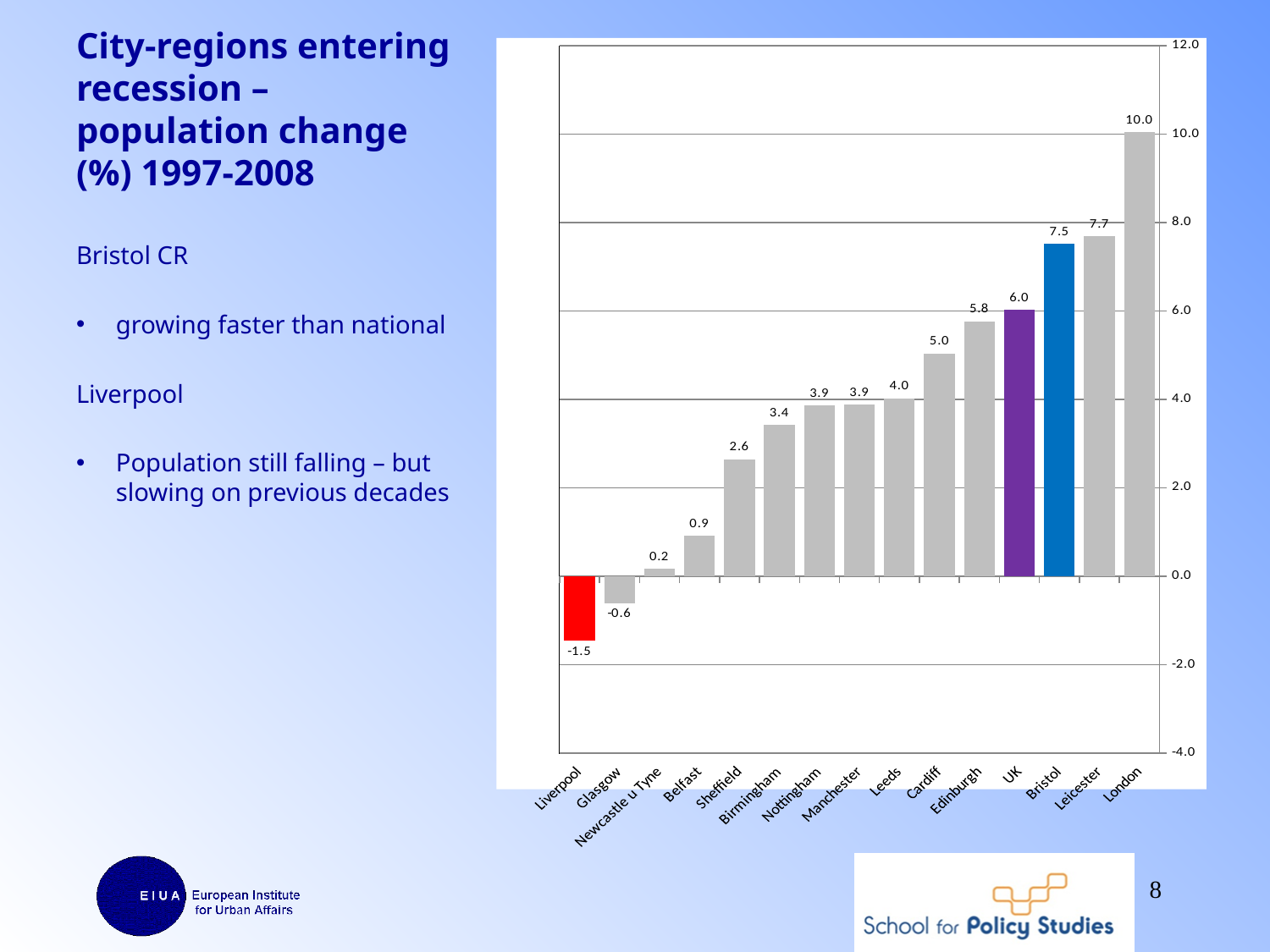
What colour is the Liverpool bar? Red Which has a larger value, Cardiff or Edinburgh? Edinburgh What is the value shown for the UK bar? 6.0 How many bars (categories) are plotted in the chart? 15 What is the difference between the values for London and Leicester? 2.3 What is the difference between the values for Bristol and the UK? 1.5 What is the population change value shown for Bristol? 7.5 Which city-region has the highest population change in the chart? London What type of chart is shown on the slide? Bar chart Which city-region has the lowest population change in the chart? Liverpool What is the value shown for Liverpool? -1.5 Is the value for Sheffield greater or less than 2.0? greater